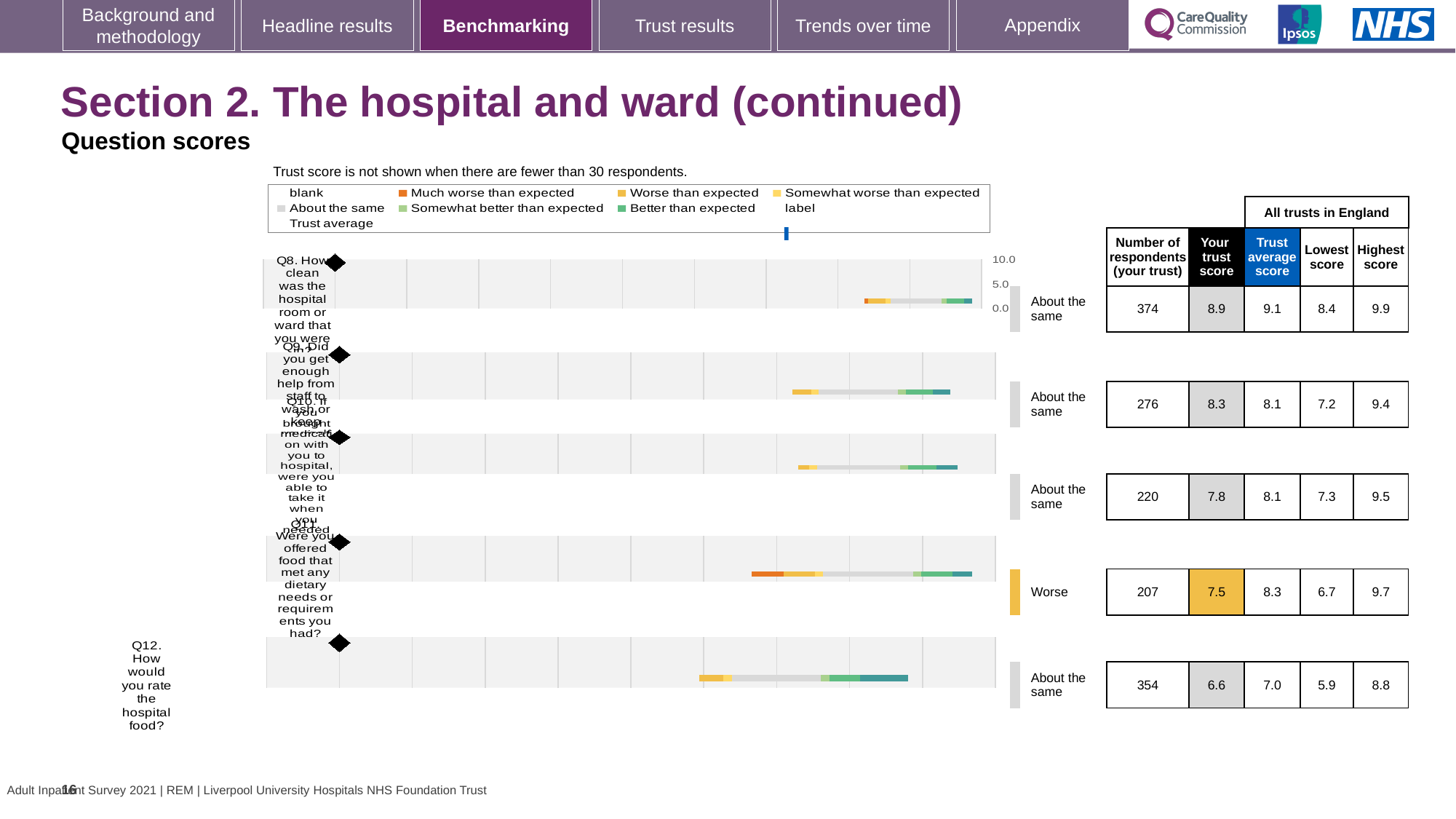
For Q9, which is larger: your trust score or the trust average score? Your trust score What is the highest score across all trusts in England for Q11 (dietary needs)? 9.7 What is the lowest score across all trusts in England for Q12? 5.9 Which question is rated 'Worse' rather than 'About the same'? Q11 How many respondents from your trust answered Q8 (How clean was the hospital room or ward)? 374 How many questions (Q8 to Q12) are plotted on the chart? 5 For Q11, what is the difference between the highest score (9.7) and the lowest score (6.7)? 3.0 What is the 'Your trust score' for Q12 (How would you rate the hospital food?)? 6.6 Which question has the lowest 'Your trust score'? Q12 What kind of chart is shown on the slide? bar chart Which question has the highest 'Your trust score'? Q8 For Q8, what is the difference between the trust average score (9.1) and your trust score (8.9)? 0.2